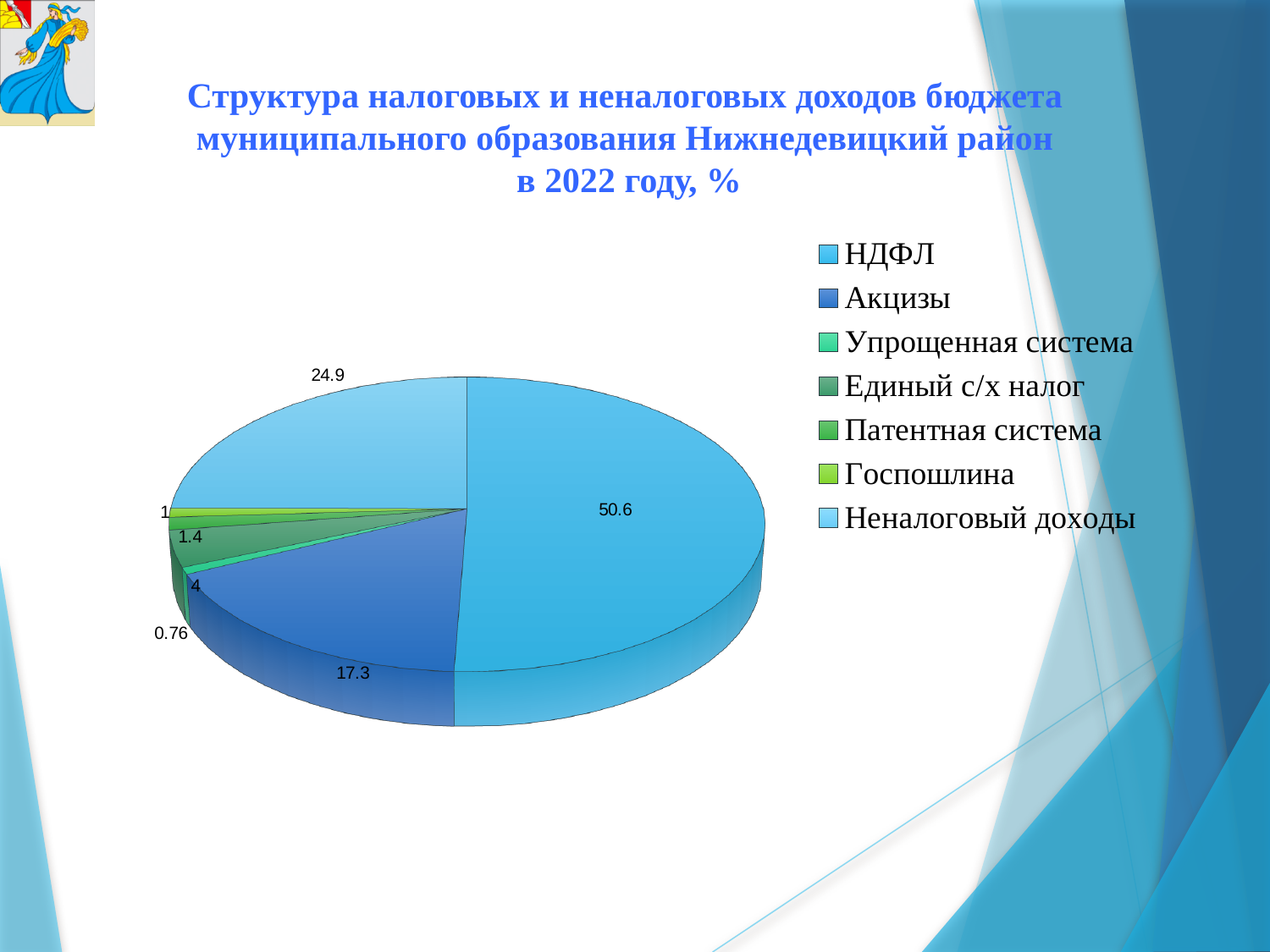
What type of chart is shown on the slide? Pie chart What is the value for НДФЛ in the pie chart? 50.6 What is the value for Акцизы in the pie chart? 17.3 What is the value for Неналоговый доходы in the pie chart? 24.9 What share of the pie does НДФЛ account for? 50.6% What is the difference between the values for НДФЛ and Неналоговый доходы? 25.7 Which is larger, the slice for Акцизы or the slice for Неналоговый доходы? Неналоговый доходы Which legend entry is listed first in the pie chart's legend? НДФЛ How many categories does the legend of the pie chart list? 7 What is the difference between the values for Неналоговый доходы and Акцизы? 7.6 Which year does the chart title say the budget revenue structure refers to? 2022 Which category has the largest slice of the pie chart? НДФЛ